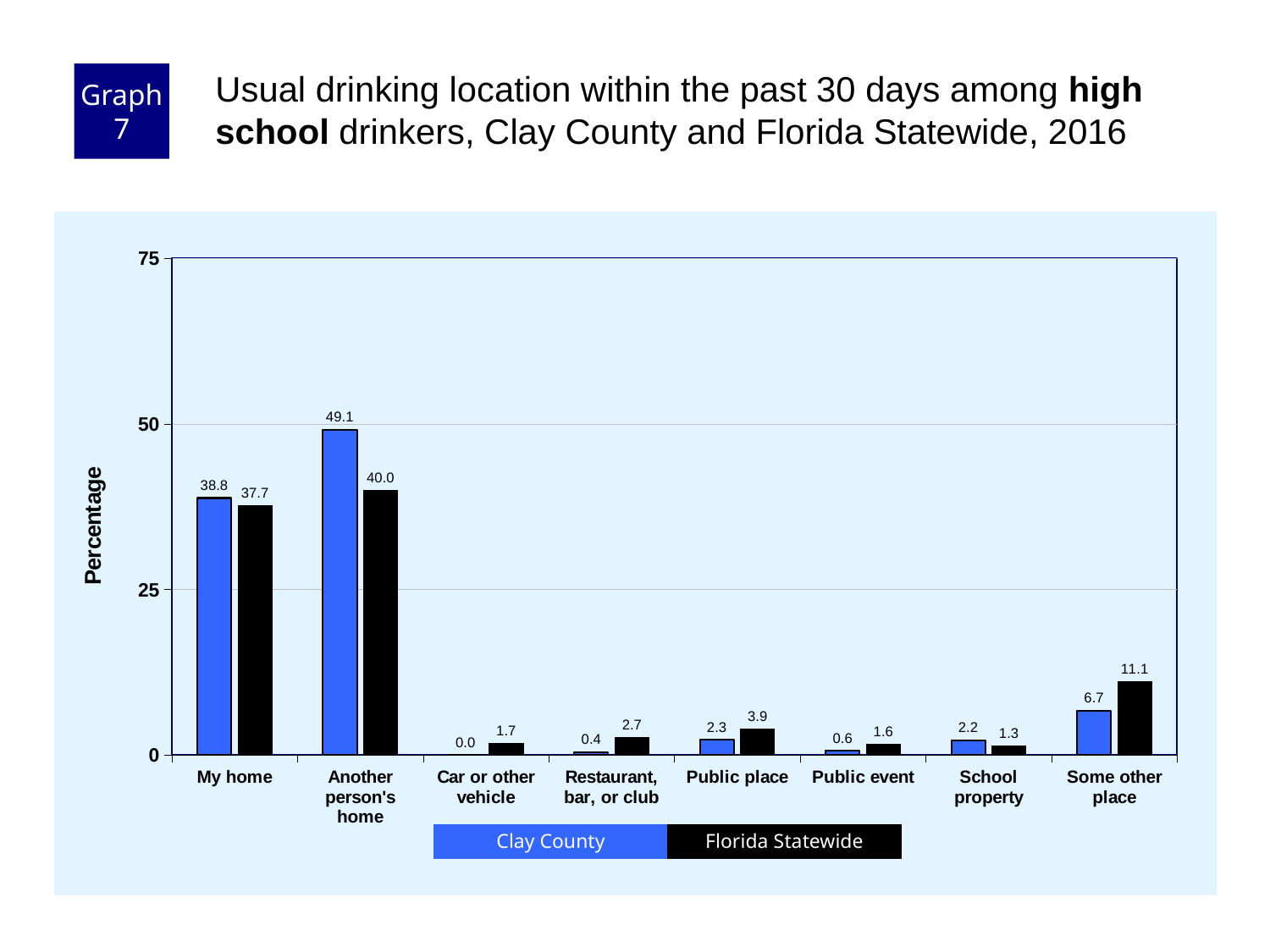
Is the Florida Statewide value for "My home" greater or less than 25? greater How many categories are shown on the x axis? 8 What kind of chart is shown on the slide? Bar chart How many series does the legend list? 2 What is the difference between the Clay County and Florida Statewide values for "Another person's home"? 9.1 Which category has the highest Clay County value? Another person's home What is the Clay County value for "Car or other vehicle"? 0.0 What is the Clay County value for "Another person's home"? 49.1 Which is larger for "Public place": Clay County or Florida Statewide? Florida Statewide Which category has the lowest Florida Statewide value? School property What is the Florida Statewide value for "Some other place"? 11.1 What is the label of the y axis? Percentage